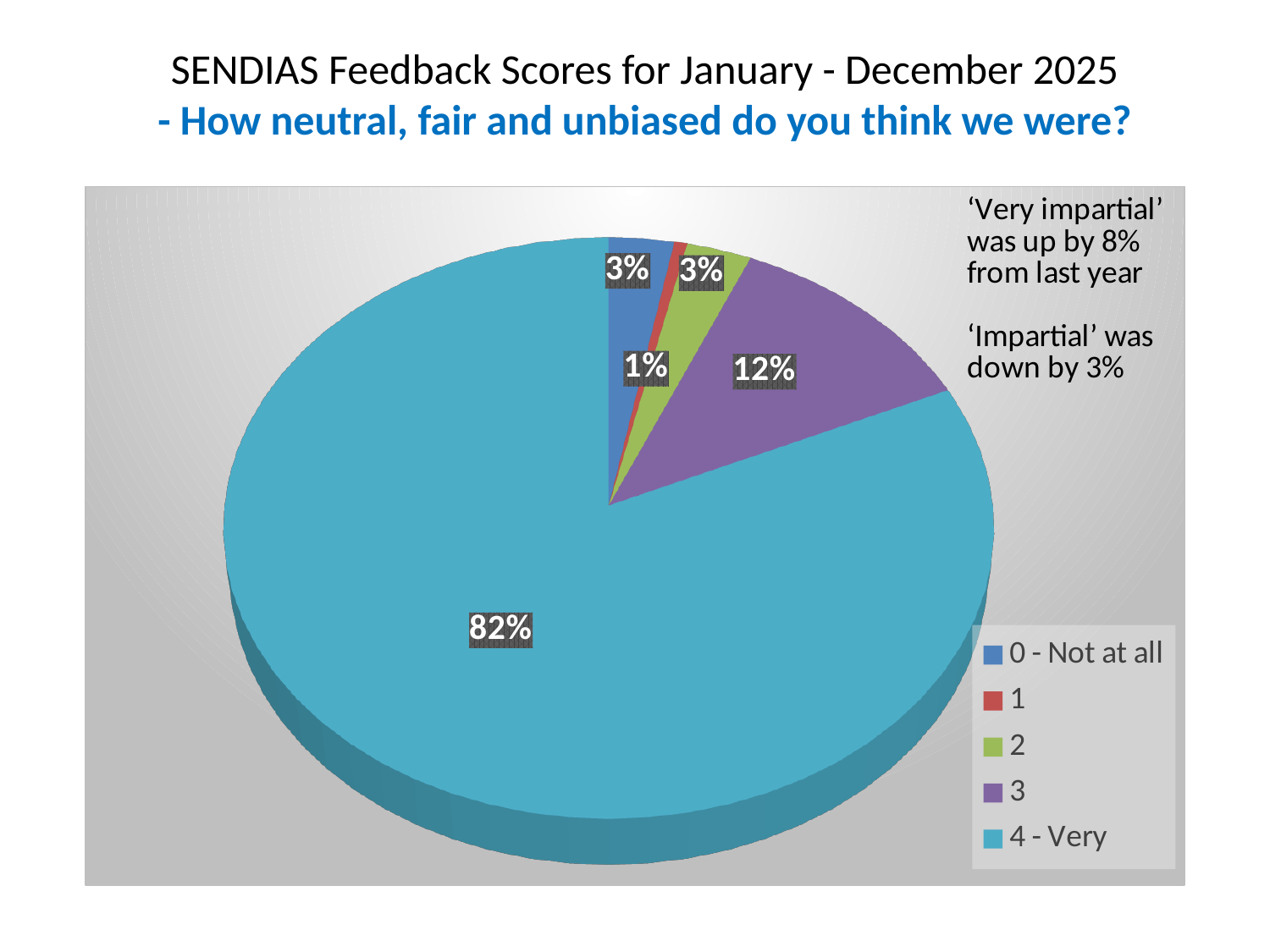
What is the value shown for the '1' slice? 1% Which category has the smallest slice of the pie? 1 What is the value shown for the '2' slice? 3% Which is larger, the '3' slice or the '0 - Not at all' slice? 3 What kind of chart is shown on the slide? pie chart What is the value shown for the '0 - Not at all' slice? 3% What is the value shown for the '3' slice? 12% How many categories does the legend list? 5 What share of the pie does the '4 - Very' slice represent? 82% What is the difference between the '4 - Very' slice and the '3' slice? 70% What colour is the '4 - Very' slice? teal (light blue) Which category has the largest slice of the pie? 4 - Very